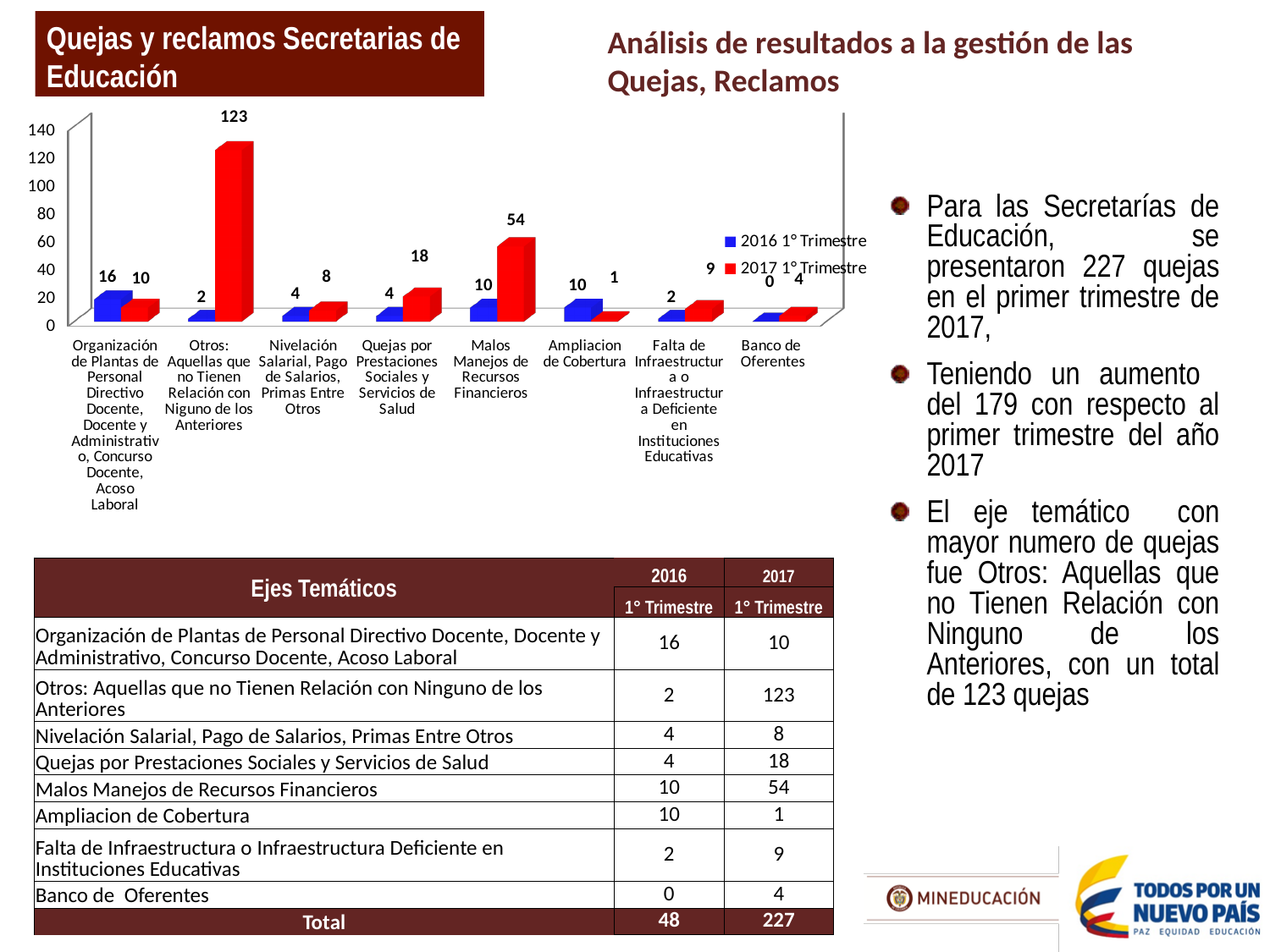
What is the value for 'Ampliacion de Cobertura' in the 2016 1° Trimestre series? 10 Which category has the lowest value in the 2016 1° Trimestre series? Banco de Oferentes How many series does the chart legend list? 2 For 'Ampliacion de Cobertura', which series has the larger value, 2016 1° Trimestre or 2017 1° Trimestre? 2016 1° Trimestre What type of chart is shown on the slide? Bar chart What is the difference between the 2017 1° Trimestre and 2016 1° Trimestre values for 'Quejas por Prestaciones Sociales y Servicios de Salud'? 14 Which category has the highest value in the 2017 1° Trimestre series? Otros: Aquellas que no Tienen Relación con Ninguno de los Anteriores What is the value for 'Malos Manejos de Recursos Financieros' in the 2017 1° Trimestre series? 54 What colour are the bars for the 2017 1° Trimestre series? Red How many categories are shown on the x axis of the chart? 8 Is the 2017 1° Trimestre value for 'Otros: Aquellas que no Tienen Relación con Ninguno de los Anteriores' greater or less than 100? greater What is the value for 'Banco de Oferentes' in the 2017 1° Trimestre series? 4